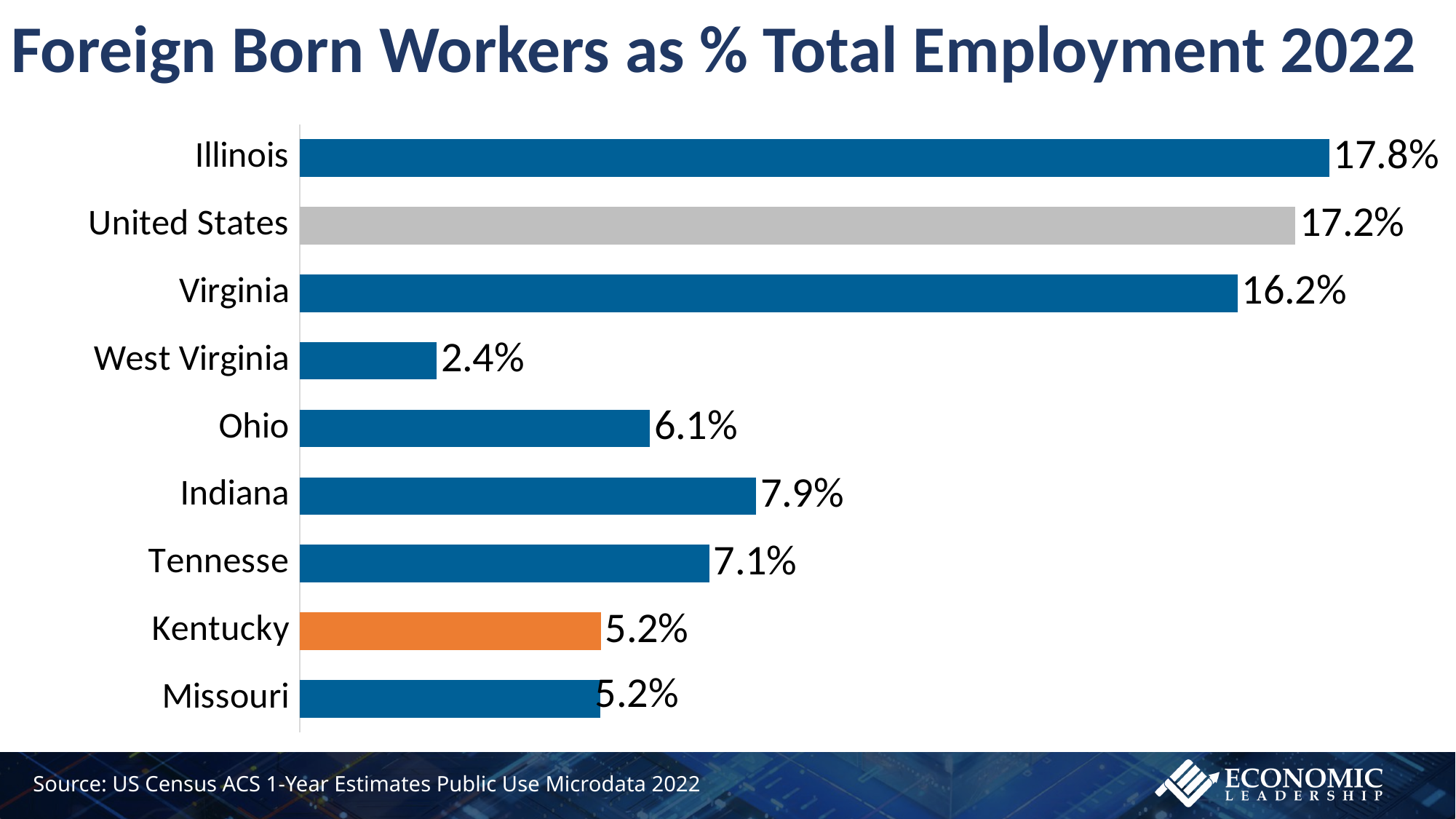
What is the value for Kentucky? 5.2% How many categories are shown in the chart? 9 What is the value for the United States? 17.2% Which category has the highest value? Illinois What is the difference between the values for Indiana and Ohio? 1.8% What is the value for West Virginia? 2.4% What is the value for Illinois? 17.8% Which category has the lowest value? West Virginia What is the difference between the values for Illinois and Virginia? 1.6% Which is larger, the value for Indiana or the value for Tennesse? Indiana Which category's bar is coloured orange? Kentucky What kind of chart is this? Bar chart